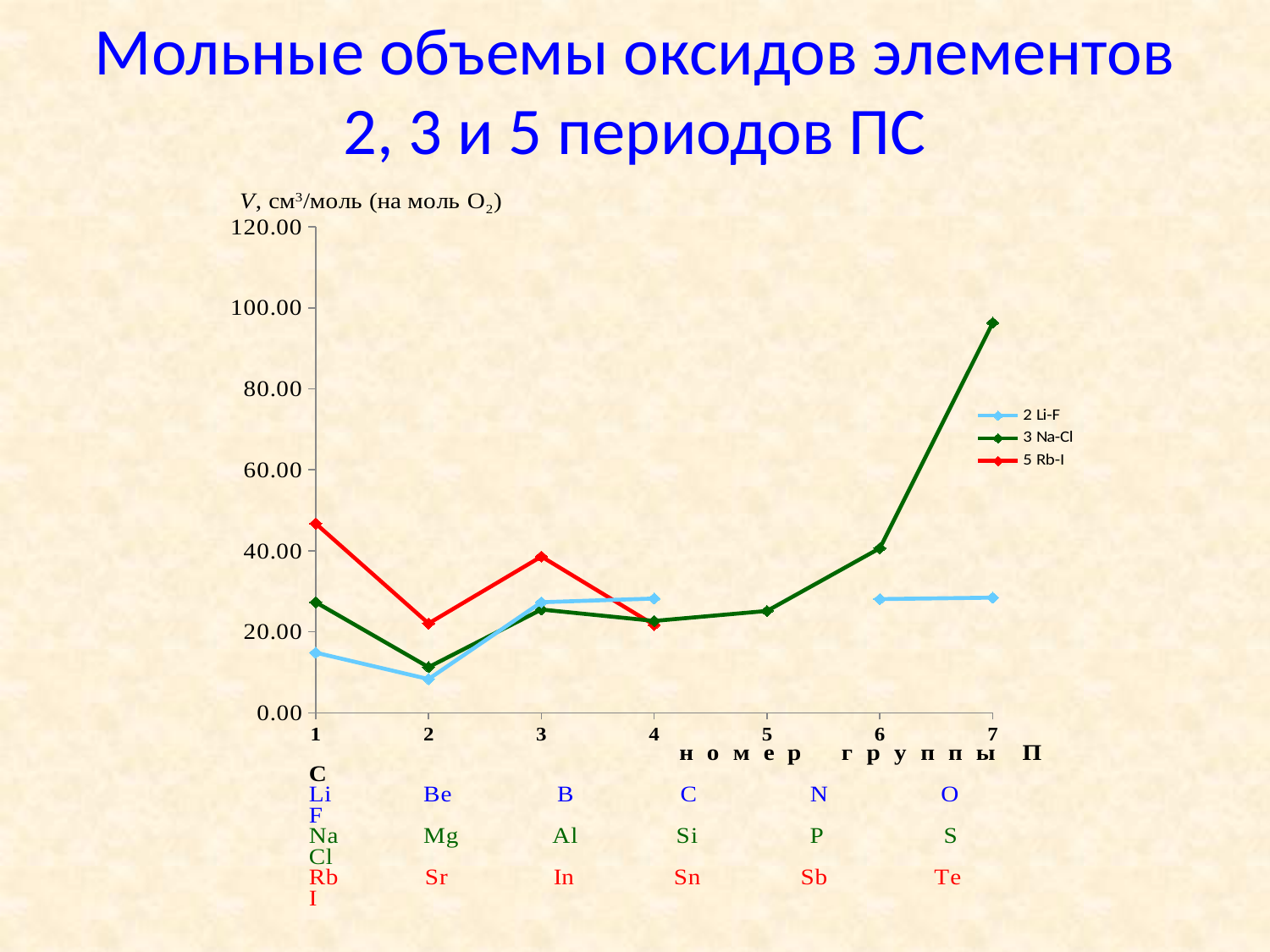
At group 1, which series has the larger value, 5 Rb-I or 2 Li-F? 5 Rb-I What kind of chart is shown on the slide? line chart For the series 2 Li-F, at which group number is the value lowest? 2 Is the value for 2 Li-F at group 2 greater or less than 20.00? less For the series 3 Na-Cl, at which group number is the value lowest? 2 Does the 3 Na-Cl series rise or fall from group 5 to group 7? rise Is the value for 5 Rb-I at group 1 greater or less than 40.00? greater How many group numbers are marked along the x axis? 7 Is the value for 3 Na-Cl at group 7 greater or less than 80.00? greater For the series 3 Na-Cl, at which group number is the value highest? 7 How many series does the legend list? 3 What are the three series named in the legend? 2 Li-F, 3 Na-Cl, 5 Rb-I